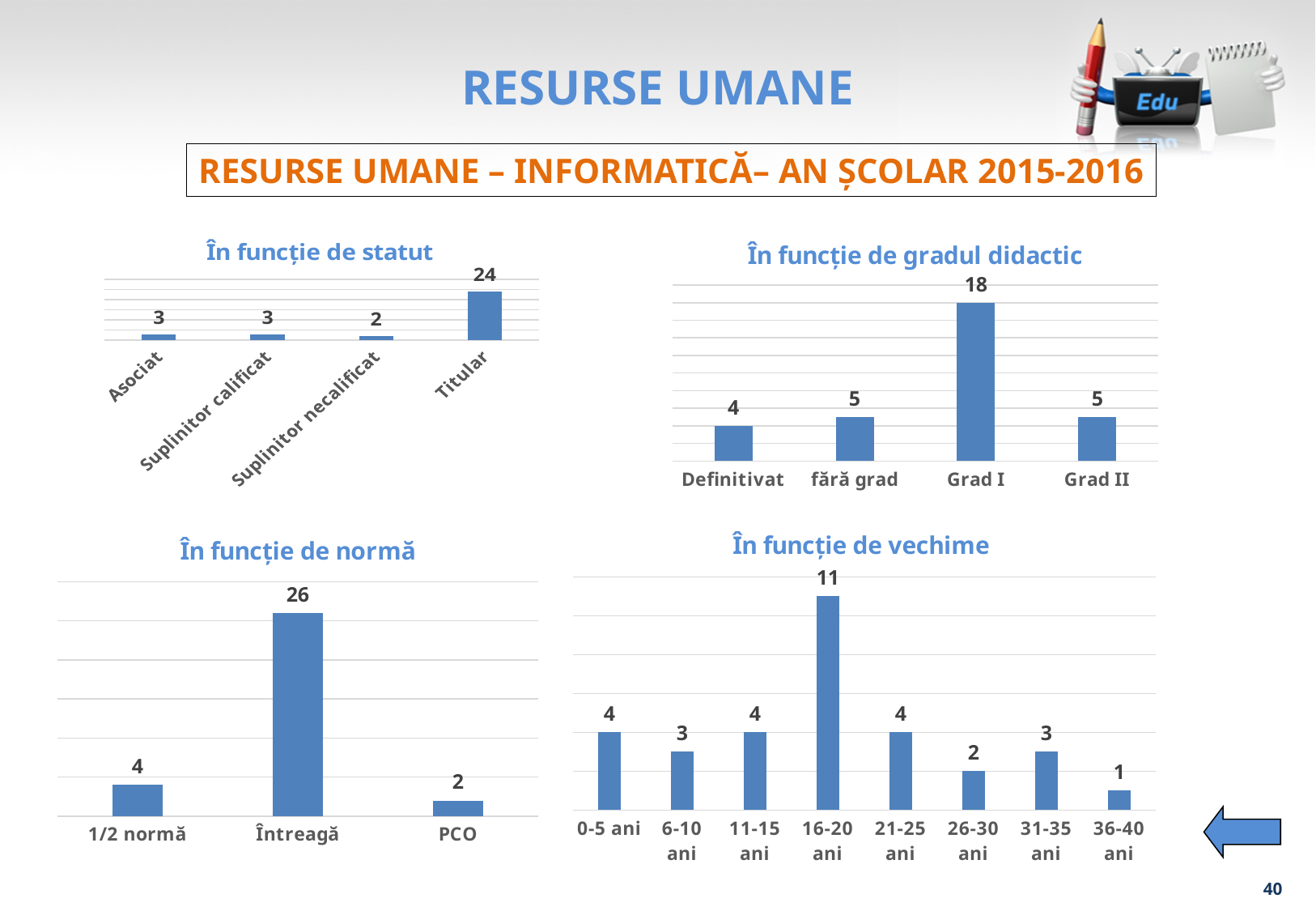
In the chart titled 'În funcție de normă', which category has the highest value? Întreagă In the chart titled 'În funcție de vechime', what is the value for 16-20 ani? 11 In the chart titled 'În funcție de normă', what is the value for PCO? 2 In the chart titled 'În funcție de vechime', which is larger, the value for 6-10 ani or the value for 26-30 ani? 6-10 ani What kind of chart is 'În funcție de vechime'? Bar chart In the chart titled 'În funcție de vechime', which category has the lowest value? 36-40 ani In the chart titled 'În funcție de gradul didactic', how many categories are shown? 4 In the chart titled 'În funcție de statut', what is the value for Titular? 24 In the chart titled 'În funcție de gradul didactic', what is the value for Grad I? 18 In the chart titled 'În funcție de statut', which category has the lowest value? Suplinitor necalificat In the chart titled 'În funcție de gradul didactic', what is the difference between Grad I and Definitivat? 14 In the chart titled 'În funcție de normă', what is the total of all three bars? 32